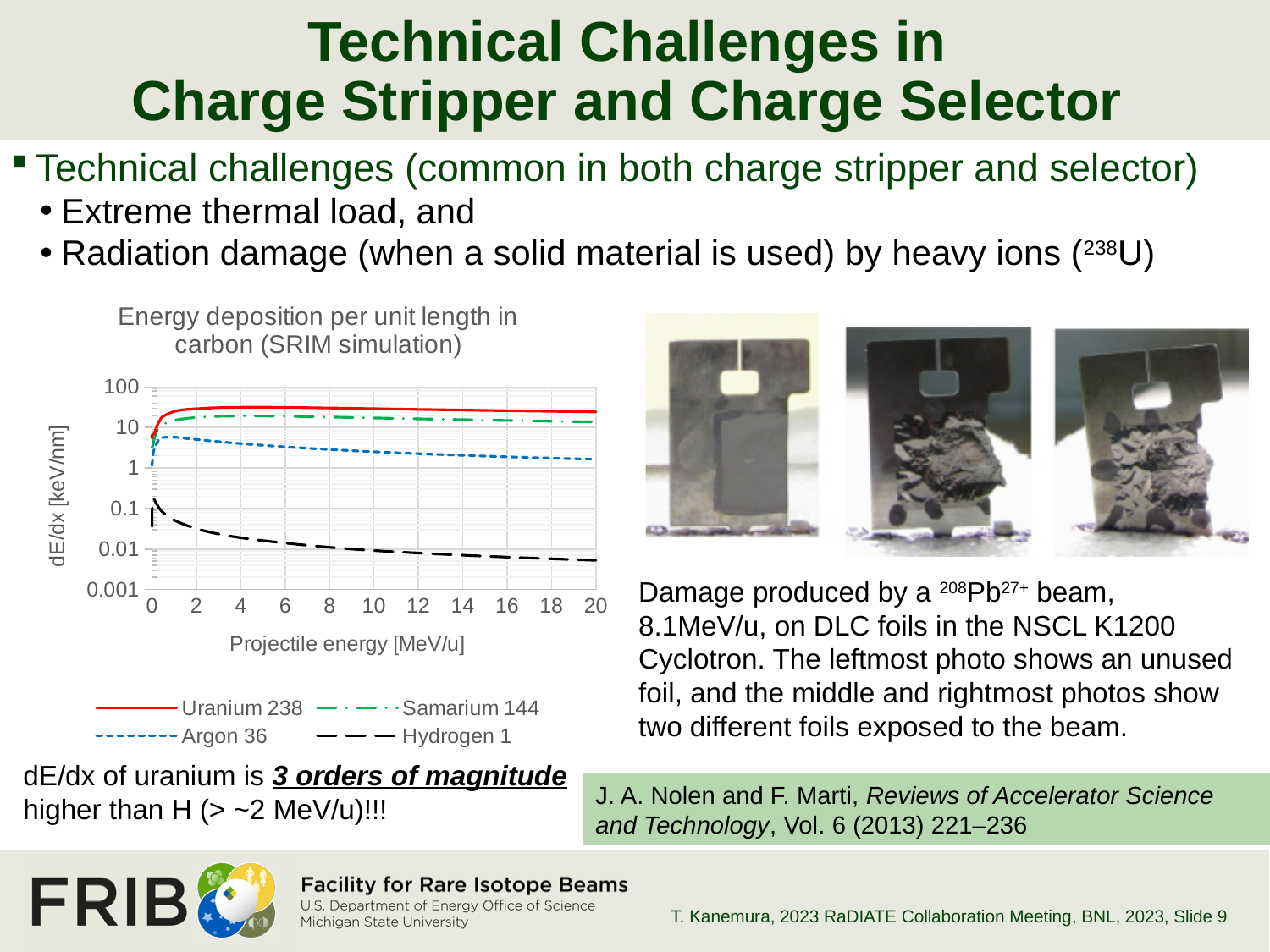
Is the dE/dx value for Argon 36 at 20 MeV/u greater or less than 1 keV/nm? greater What is the label of the chart's x axis? Projectile energy [MeV/u] What kind of chart is shown on the slide? line chart Is the dE/dx value for Uranium 238 at 10 MeV/u greater or less than 10 keV/nm? greater At 10 MeV/u, which series has the larger dE/dx, Argon 36 or Samarium 144? Samarium 144 Is the dE/dx value for Hydrogen 1 at 10 MeV/u greater or less than 0.1 keV/nm? less How many series does the chart legend list? 4 Which series has the highest dE/dx at a projectile energy of 10 MeV/u? Uranium 238 Which series has the lowest dE/dx at a projectile energy of 10 MeV/u? Hydrogen 1 At 10 MeV/u, which series has the larger dE/dx, Hydrogen 1 or Argon 36? Argon 36 What is the title of the chart? Energy deposition per unit length in carbon (SRIM simulation) Does the dE/dx for Hydrogen 1 rise or fall as projectile energy increases from 2 to 20 MeV/u? fall